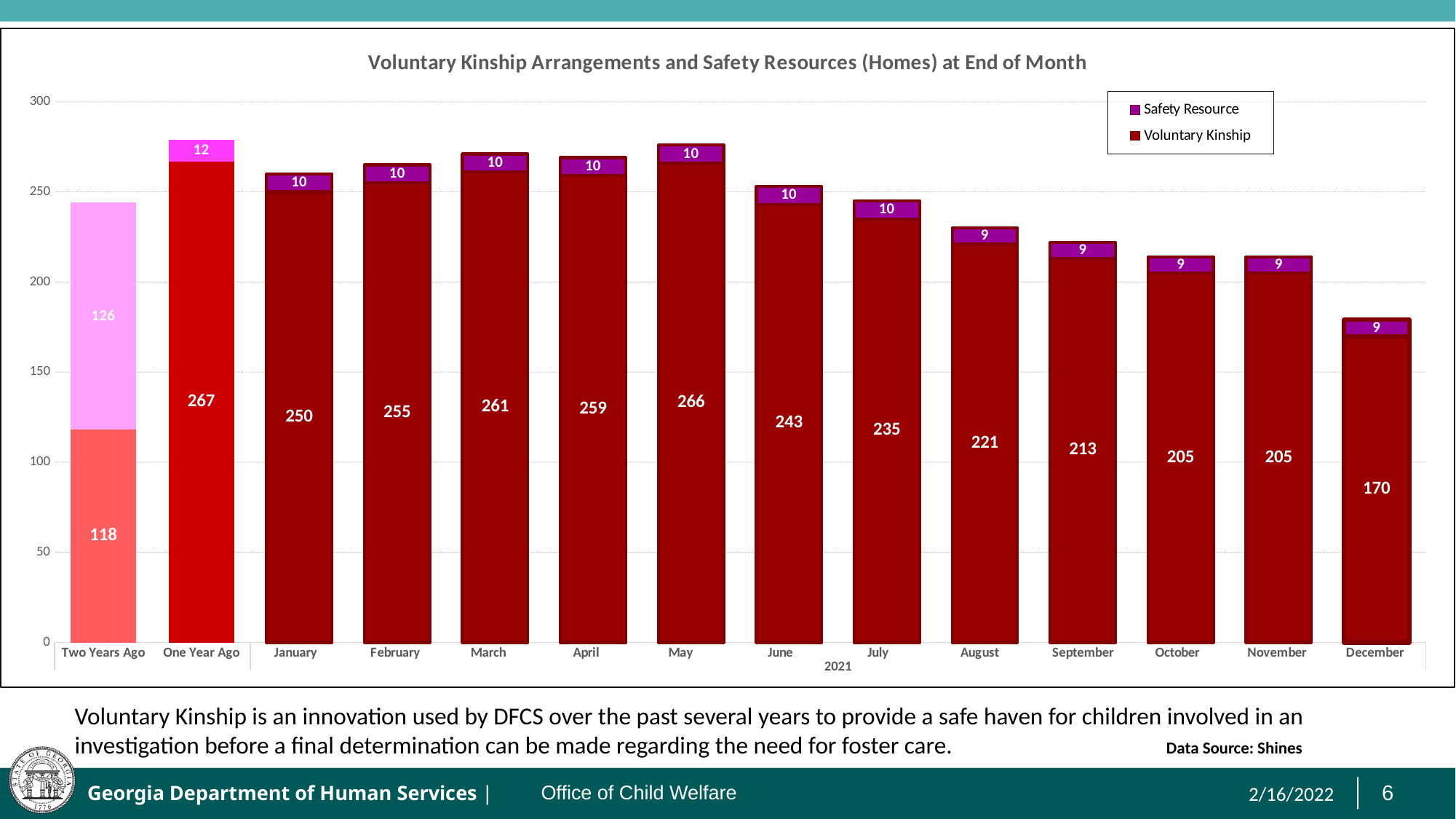
Which category has the highest Voluntary Kinship value? One Year Ago Which month of 2021 has the lowest Voluntary Kinship value? December What is the Voluntary Kinship value for March? 261 What is the difference between the Voluntary Kinship values for May and June? 23 How many series does the legend list? 2 Which is larger, the Voluntary Kinship value for August or for September? August What is the Voluntary Kinship value for Two Years Ago? 118 What is the total of the stacked bar for One Year Ago? 279 What kind of chart is shown on the slide? Stacked bar chart What is the total of the stacked bar for December? 179 What is the Safety Resource value for December? 9 How many categories are shown on the x axis? 14